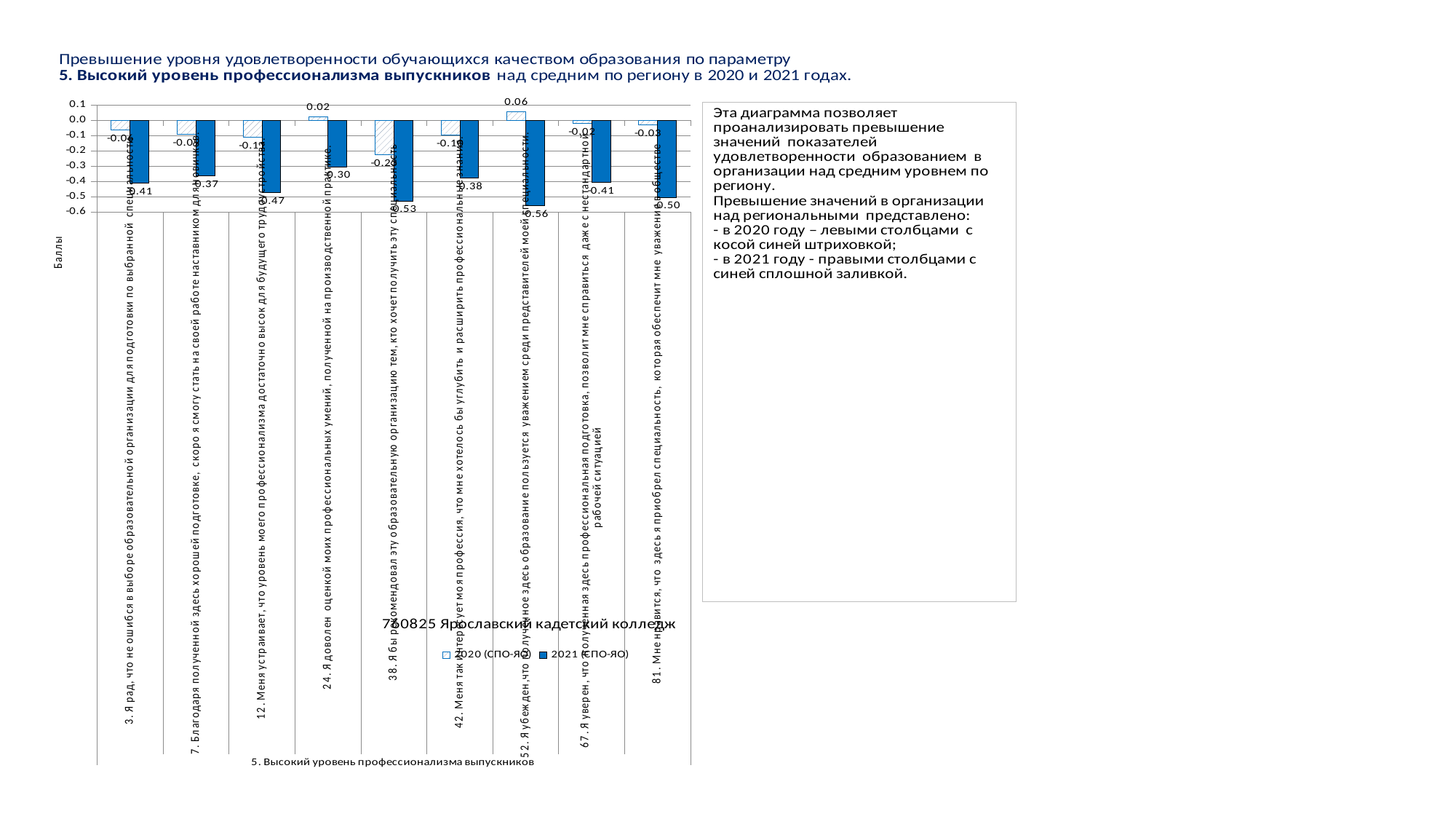
Which statement has the lowest 2021 (СПО-ЯО) value? 52. Я убежден, что полученное здесь образование пользуется уважением среди представителей моей специальности What is the 2021 (СПО-ЯО) value for statement 38 (Я бы рекомендовал эту образовательную организацию...)? -0.53 What are the two legend entries of the chart? 2020 (СПО-ЯО) and 2021 (СПО-ЯО) Which statement has the highest 2020 (СПО-ЯО) value? 52. Я убежден, что полученное здесь образование пользуется уважением среди представителей моей специальности What is the difference between the 2020 and 2021 values for statement 12 (Меня устраивает, что уровень моего профессионализма...)? 0.36 For statement 7 (Благодаря полученной здесь хорошей подготовке...), which is larger: the 2020 value or the 2021 value? 2020 (СПО-ЯО) What is the 2020 (СПО-ЯО) value for statement 52 (Я убежден, что полученное здесь образование пользуется уважением...)? 0.06 What is the title printed on the chart? 760825 Ярославский кадетский колледж What type of chart is shown on the slide? Bar chart How many series does the legend list? 2 What is the 2021 (СПО-ЯО) value for statement 24 (Я доволен оценкой моих профессиональных умений...)? -0.30 How many categories (statements) are plotted along the x axis? 9